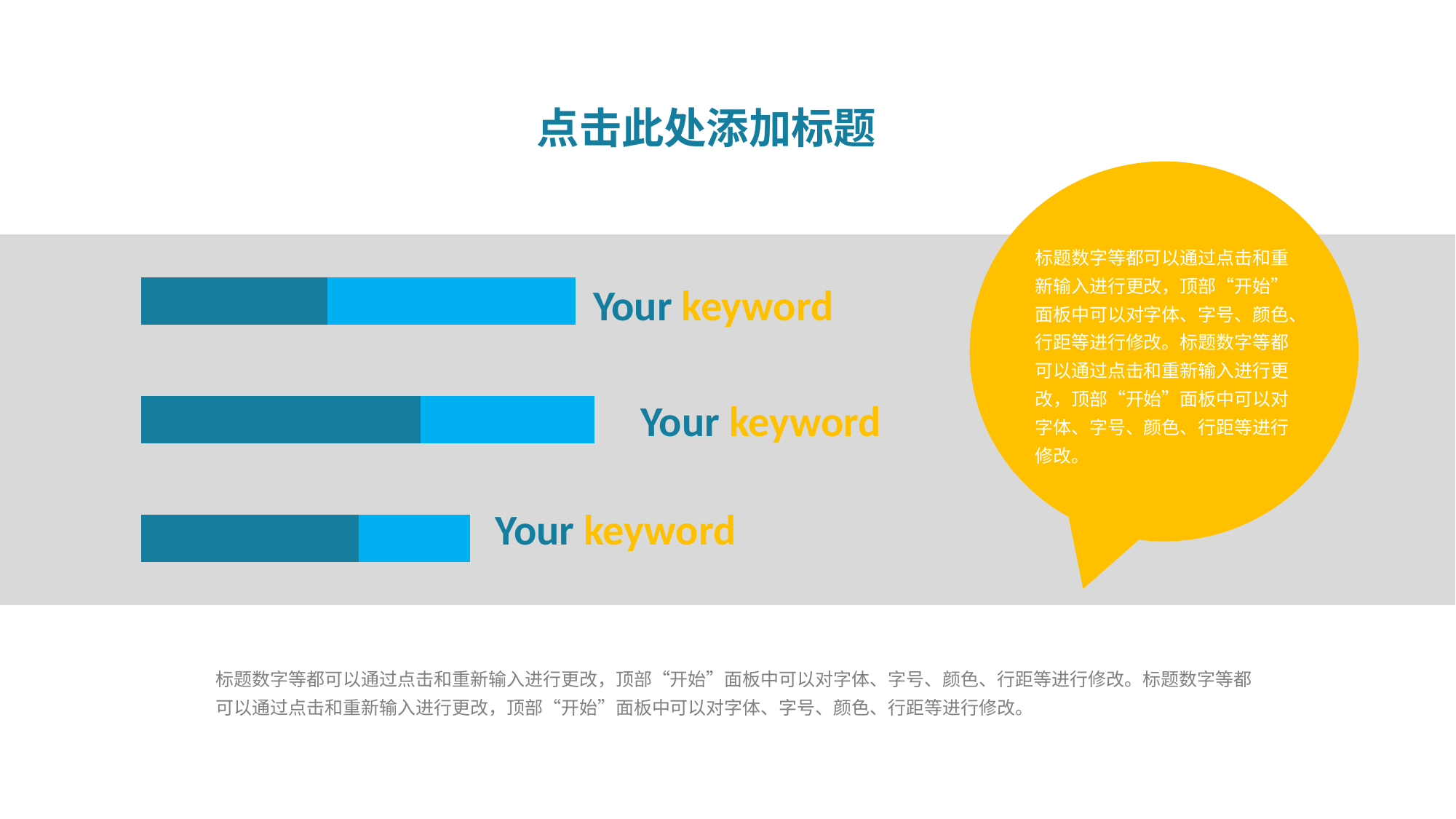
What kind of chart is shown on the slide? bar chart Which bar is longer, the top bar or the bottom bar? top Which bar is longer, the middle bar or the bottom bar? middle How many bars does the chart contain? 3 What label text appears next to each bar? Your keyword Which bar is the shortest: the top, middle or bottom bar? bottom How many coloured segments does each bar have? 2